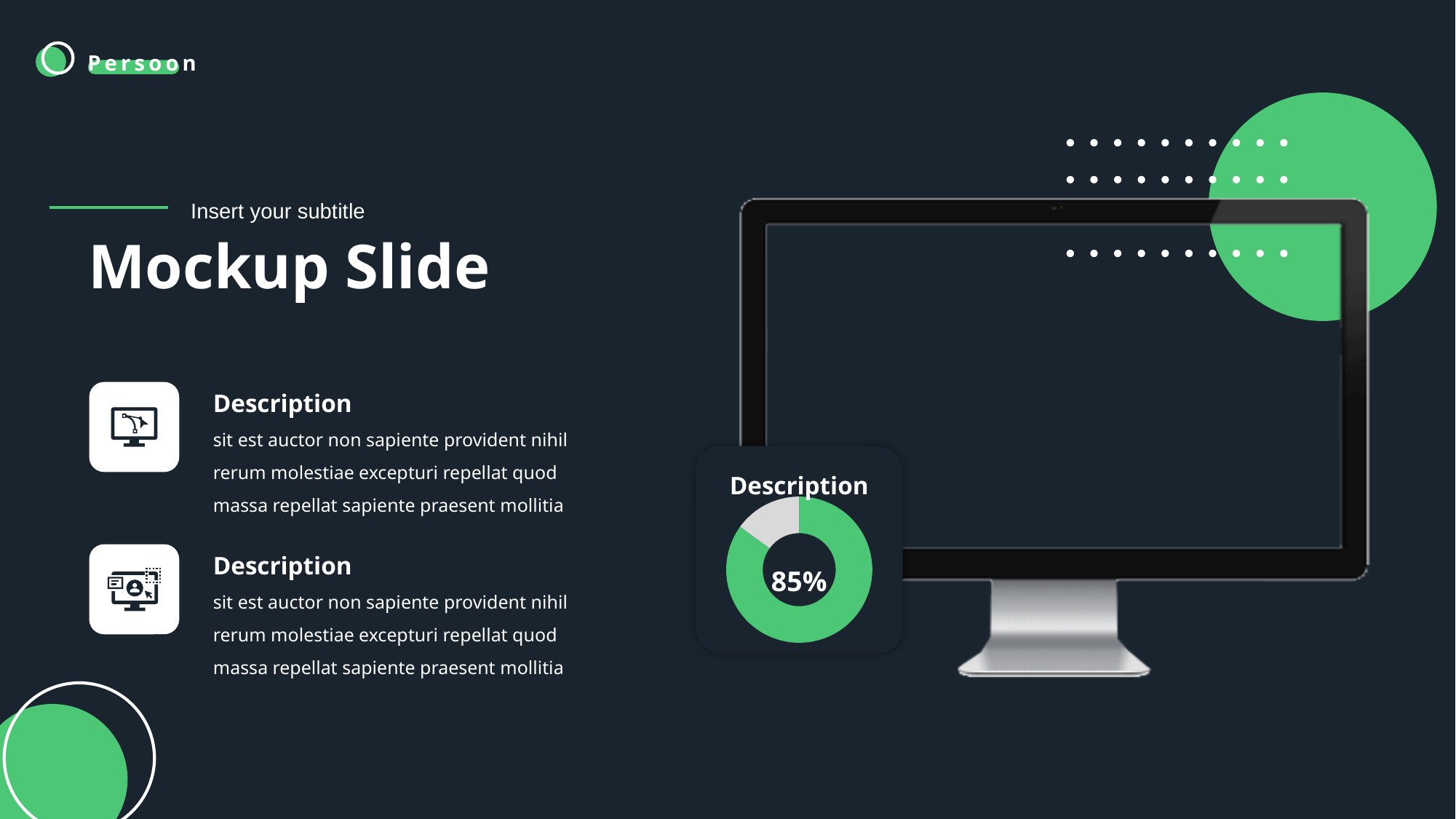
Which slice of the doughnut chart is larger, the green one or the grey one? green Which slice of the doughnut chart is the smallest? the grey slice What share of the doughnut chart does the grey slice represent? 15% What kind of chart is shown on the slide? doughnut chart How many slices does the doughnut chart have? 2 What colour is the largest slice of the doughnut chart? green What is the title shown above the doughnut chart? Description Is the value shown in the doughnut chart greater or less than 50%? greater What percentage is printed in the centre of the doughnut chart? 85%